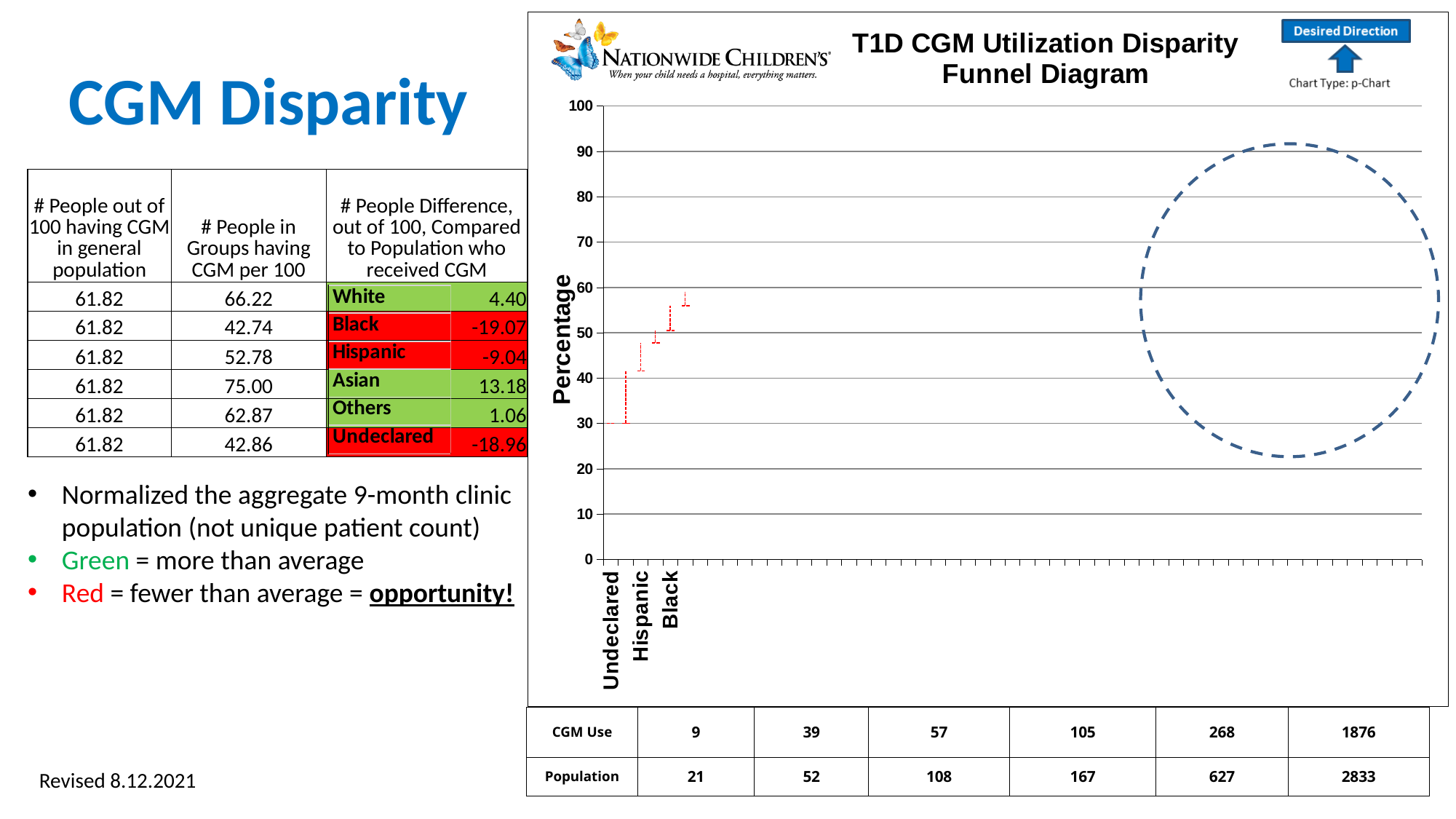
In the data table below the funnel diagram, what is the difference between the Population and CGM Use values in the last column? 957 In the funnel diagram, is the plotted value for Undeclared greater or less than 50? less In the data table below the funnel diagram, what is the smallest Population value? 21 What is the title of the chart on the right side of the slide? T1D CGM Utilization Disparity Funnel Diagram What chart type is stated in the top-right corner of the chart? p-Chart In the data table below the funnel diagram, what is the largest CGM Use value? 1876 What is the label on the y axis of the funnel diagram? Percentage How many value columns does the data table below the funnel diagram contain? 6 How many category labels are readable on the x axis of the funnel diagram? 3